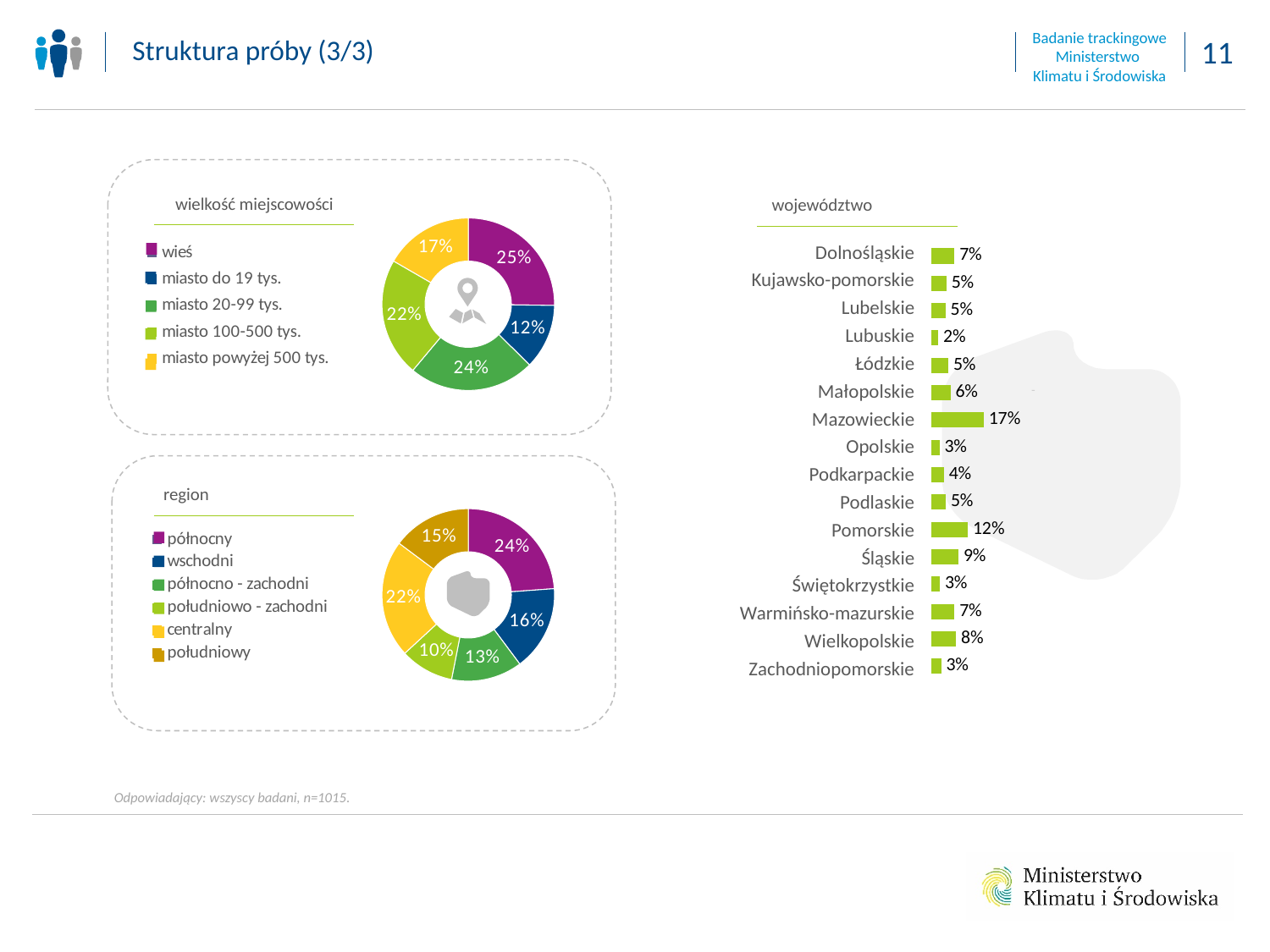
In the 'województwo' chart, which is larger: Pomorskie or Śląskie? Pomorskie In the 'województwo' chart, what is the value for Mazowieckie? 17% In the 'wielkość miejscowości' chart, how many categories does the legend list? 5 In the 'województwo' chart, how many voivodeships are shown? 16 In the 'region' chart, what is the difference between 'wschodni' and 'południowo - zachodni'? 6% In the 'region' chart, what share is 'centralny'? 22% In the 'wielkość miejscowości' chart, which category has the smallest share? miasto do 19 tys. In the 'województwo' chart, which voivodeship has the lowest value? Lubuskie What kind of chart is the 'region' chart? Donut (pie) chart In the 'region' chart, which region has the largest share? północny In the 'wielkość miejscowości' chart, what share is 'miasto do 19 tys.'? 12% In the 'wielkość miejscowości' chart, what share is 'wieś'? 25%